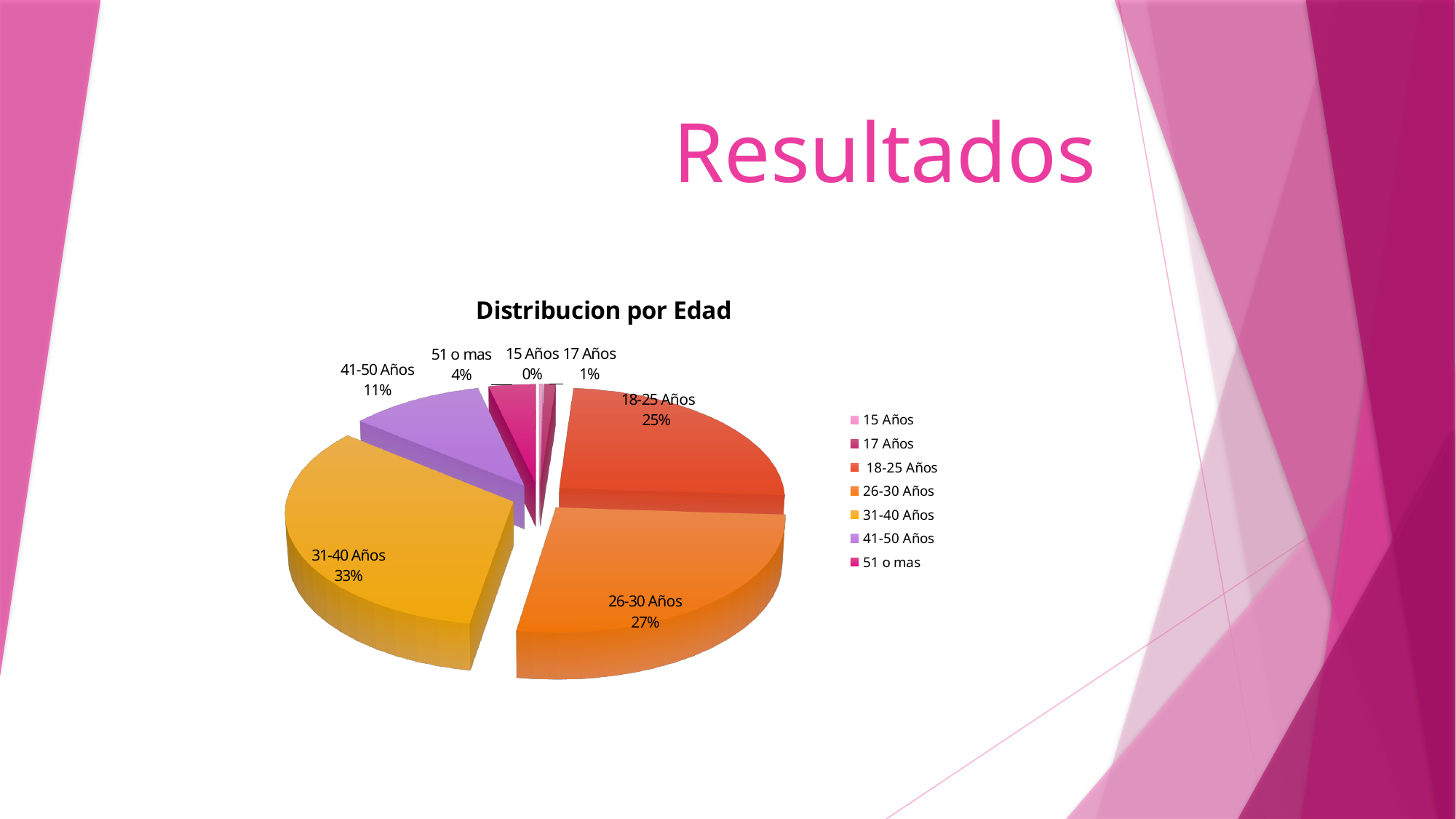
What percentage is shown for the 41-50 Años category? 11% What is the difference in percentage points between the 31-40 Años and 18-25 Años slices? 8 What share of the pie does the 31-40 Años slice represent? 33% What kind of chart is shown on the slide? Pie chart Which age category has the largest share of the pie? 31-40 Años What percentage is shown for the 18-25 Años category? 25% How many categories does the legend list? 7 Which is larger, the share for 26-30 Años or the share for 41-50 Años? 26-30 Años What percentage is shown for the 26-30 Años category? 27% Which age category has the smallest share of the pie? 15 Años What is the title of the chart? Distribucion por Edad What percentage is shown for the 51 o mas category? 4%